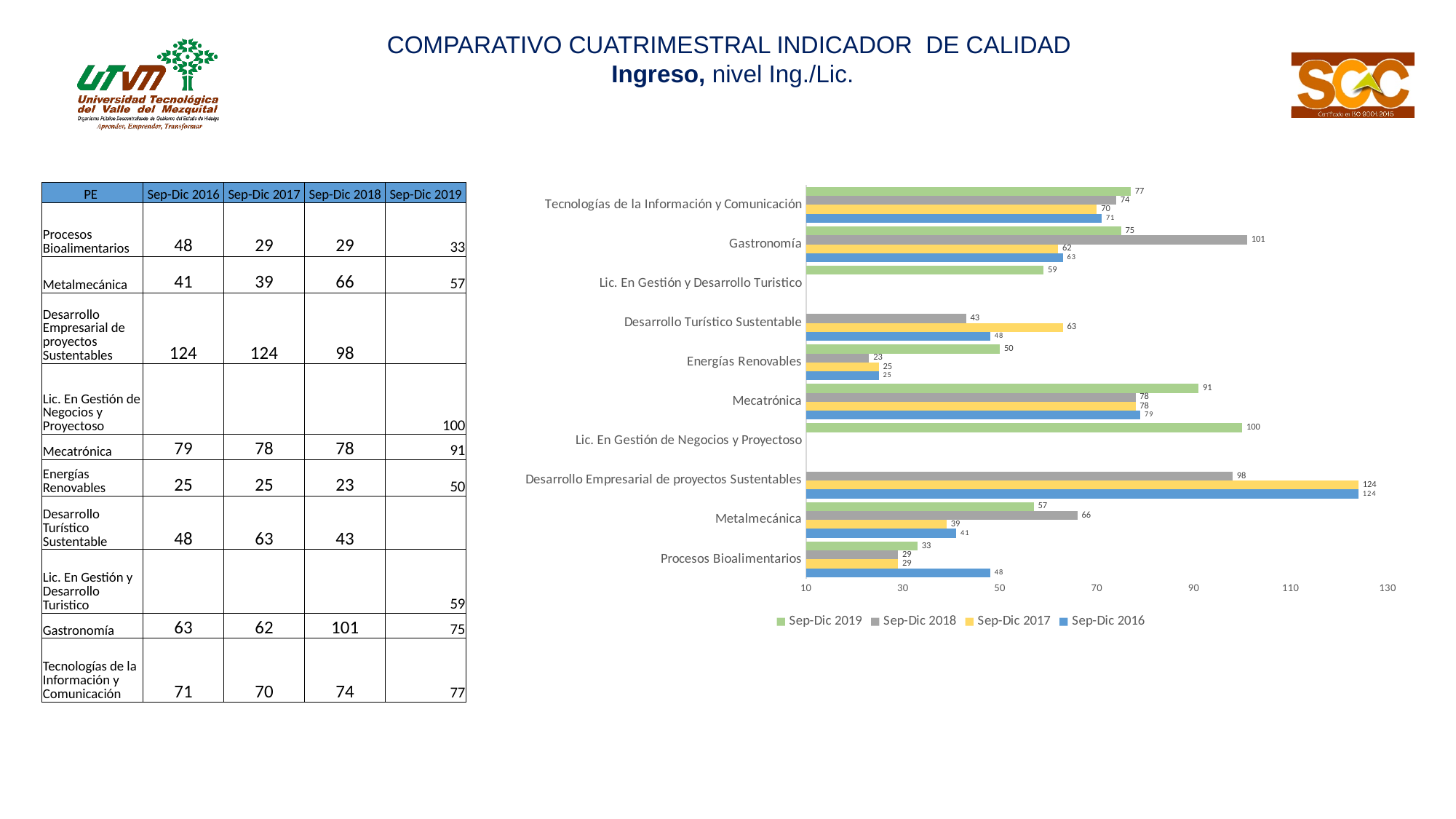
For Metalmecánica, which is larger: the Sep-Dic 2018 value or the Sep-Dic 2019 value? Sep-Dic 2018 Which category has the lowest Sep-Dic 2018 value in the chart? Energías Renovables Is the Sep-Dic 2019 value for Lic. En Gestión de Negocios y Proyectoso greater or less than 90? greater How many series does the chart legend list? 4 What is the difference between the Sep-Dic 2019 and Sep-Dic 2018 values for Energías Renovables? 27 How many categories (programs) are shown on the chart's vertical axis? 10 What is the Sep-Dic 2018 value for Gastronomía in the chart? 101 What is the Sep-Dic 2016 value for Procesos Bioalimentarios in the chart? 48 Which category has the highest Sep-Dic 2017 value in the chart? Desarrollo Empresarial de proyectos Sustentables Which legend entry is shown in green in the chart? Sep-Dic 2019 What type of chart is shown on the slide? bar chart What is the Sep-Dic 2019 value for Mecatrónica in the chart? 91